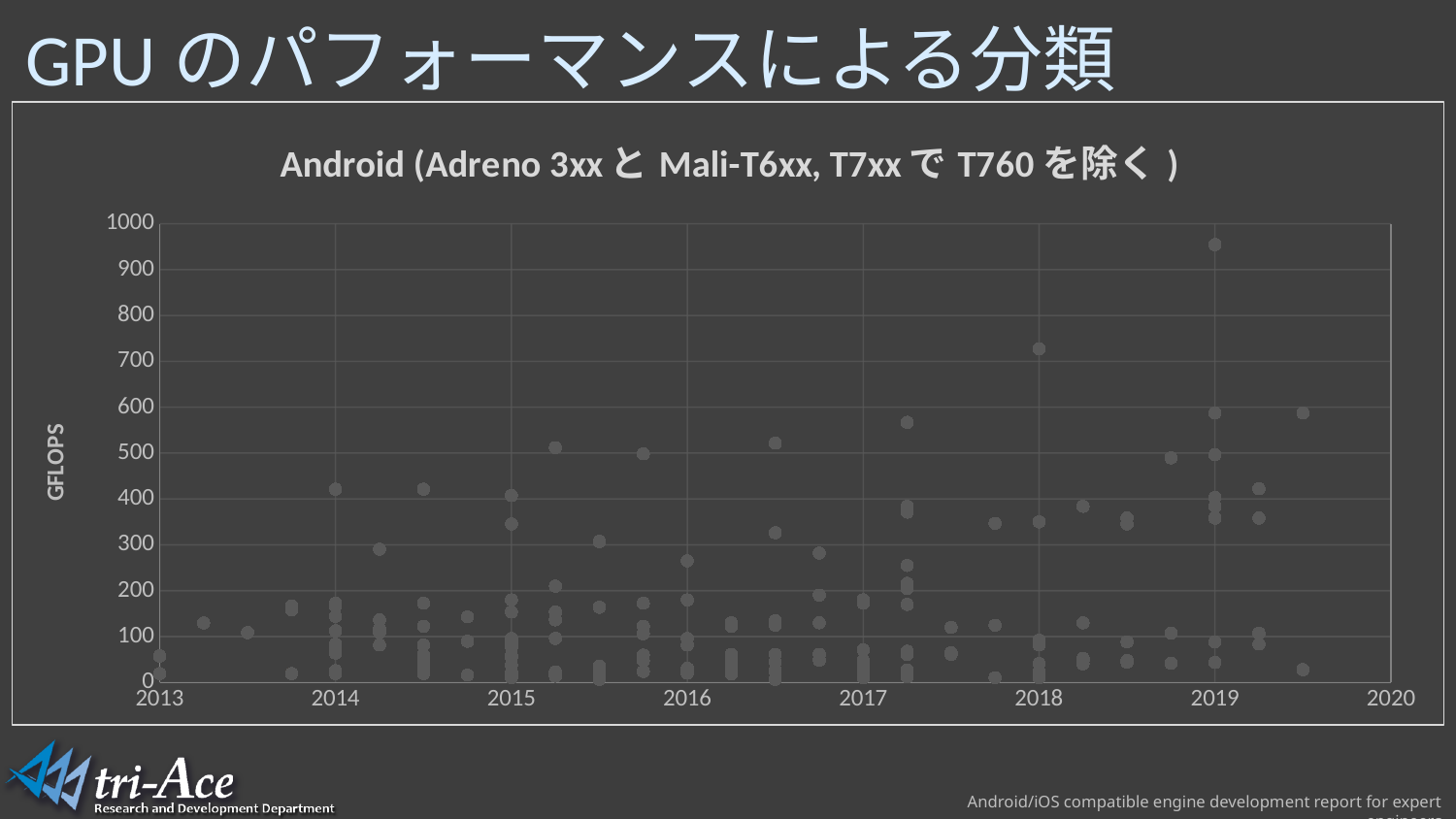
Is the highest point near 2018 greater or less than 700 GFLOPS? greater Do the maximum GFLOPS values generally rise or fall from 2013 to 2019? rise How many year labels are shown along the x axis? 8 Is the highest point near 2013 greater or less than 200 GFLOPS? less What kind of chart is shown on the slide? scatter chart Is the highest point on the chart greater or less than 900 GFLOPS? greater What is the title of the chart? Android (Adreno 3xx と Mali-T6xx, T7xx で T760 を除く ) What is the label on the vertical axis of the chart? GFLOPS Around which year on the x axis does the highest point on the chart appear? 2019 Which is larger: the highest point near 2019 or the highest point near 2018? the highest point near 2019 What is the maximum value shown on the vertical axis? 1000